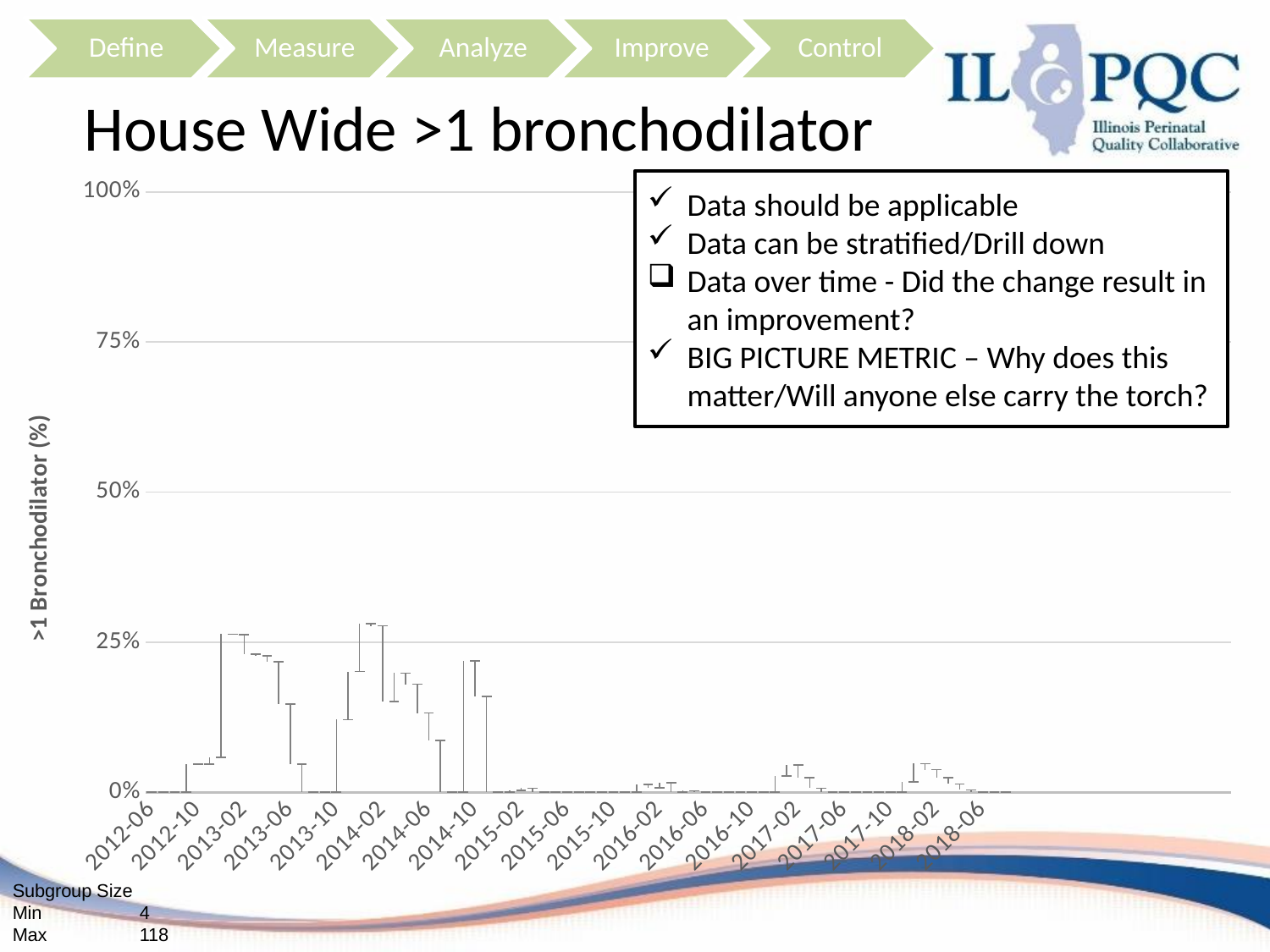
Is the value for 2013-02 greater or less than 50%? less What is the minimum subgroup size listed below the chart? 4 What is the first month label shown on the horizontal axis? 2012-06 What is the title of the chart? House Wide >1 bronchodilator Is the value for 2015-06 greater or less than 25%? less What type of chart is shown on the slide? line chart Do the values generally rise or fall from 2014-02 to 2018-06? fall What is the maximum subgroup size listed below the chart? 118 What is the highest value shown on the vertical axis of the chart? 100% Which is higher, the value for 2013-02 or the value for 2015-10? 2013-02 What is the label on the vertical axis of the chart? >1 Bronchodilator (%) Is the value for 2016-10 greater or less than 50%? less